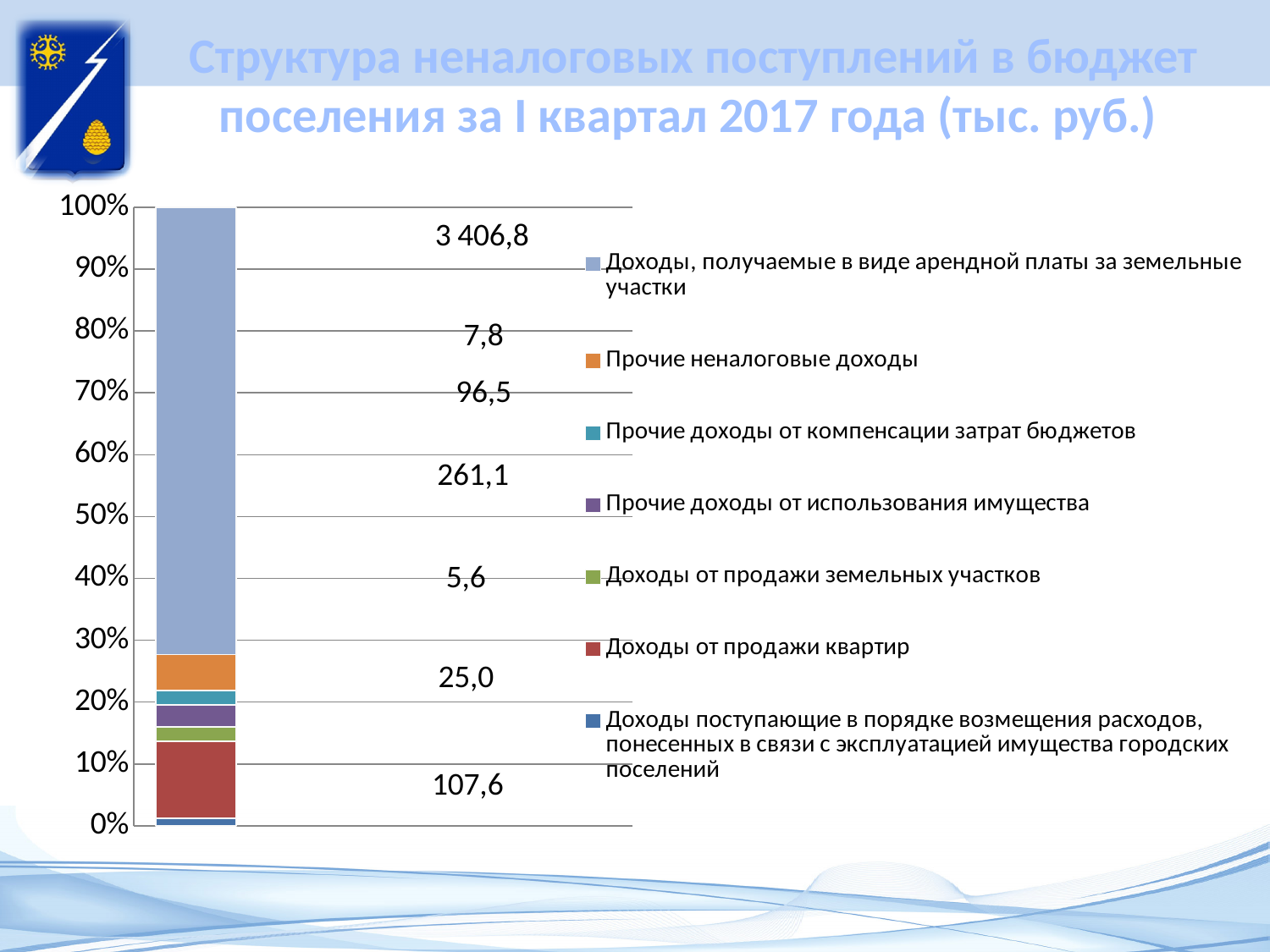
What is the difference between the values for 'Прочие доходы от использования имущества' and 'Прочие доходы от компенсации затрат бюджетов'? 164,6 Which is larger: the value for 'Прочие неналоговые доходы' or the value for 'Доходы от продажи земельных участков'? Прочие неналоговые доходы How many series does the legend list? 7 What kind of chart is shown on the slide? Stacked bar chart Is the share of the bar taken by 'Доходы, получаемые в виде арендной платы за земельные участки' greater or less than 50%? greater What value is shown for 'Прочие доходы от использования имущества'? 261,1 What is the total of all values in the stacked bar? 3 910,4 What value is shown for 'Доходы, получаемые в виде арендной платы за земельные участки'? 3 406,8 What value is shown for 'Прочие доходы от компенсации затрат бюджетов'? 96,5 Which category has the highest value? Доходы, получаемые в виде арендной платы за земельные участки What value is shown for 'Доходы от продажи квартир'? 25,0